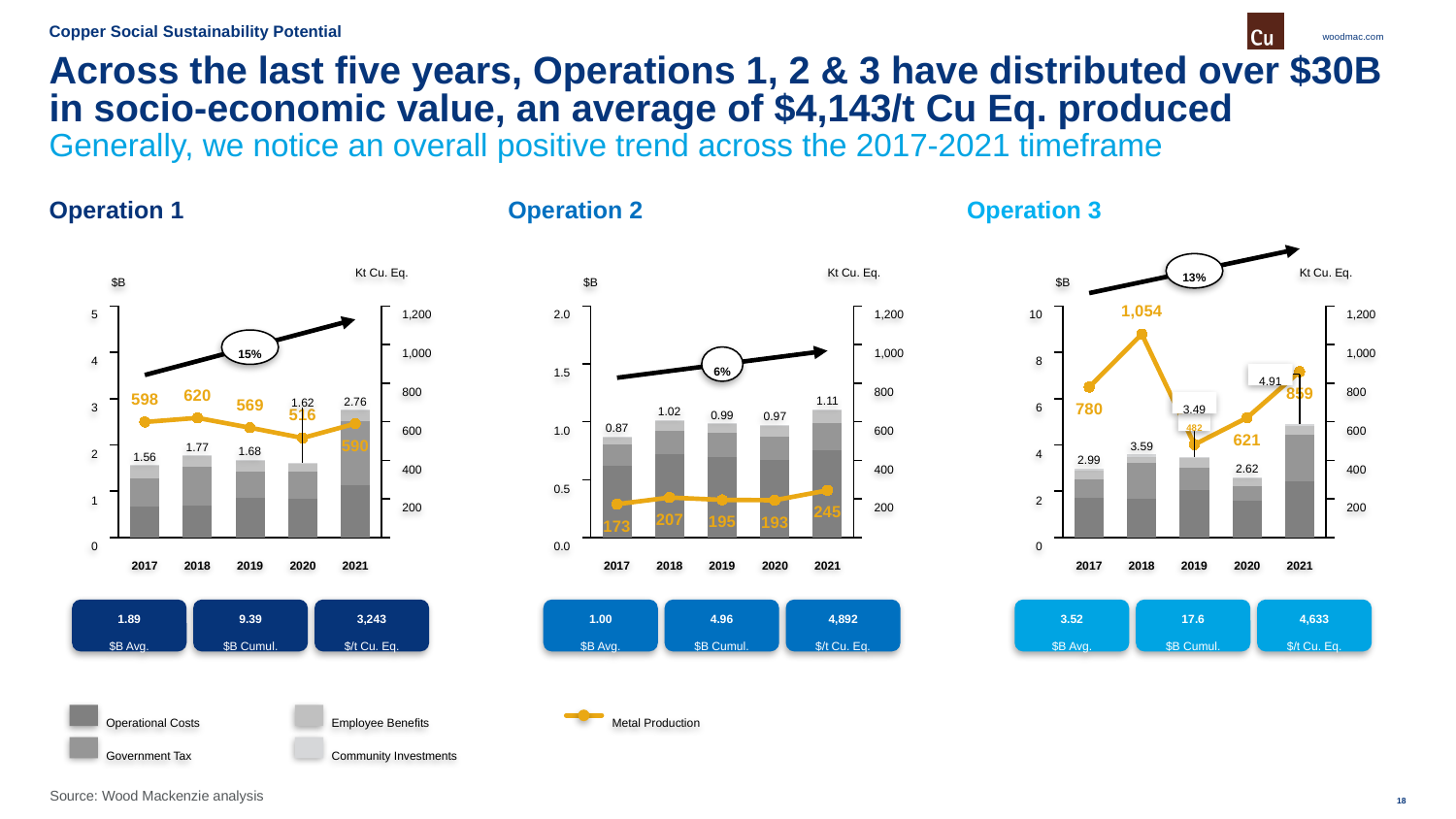
In the Operation 1 chart, what is the Metal Production value for 2020? 516 How many series does the legend at the bottom of the slide list? 5 In the Operation 3 chart, what is the difference between the Metal Production values for 2018 and 2017? 274 How many years are shown on the x axis of the Operation 1 chart? 5 In the Operation 2 chart, which year has the larger total bar value, 2018 or 2019? 2018 In the Operation 2 chart, is the Metal Production value for 2021 greater or less than 400? less In the Operation 3 chart, which year has the highest Metal Production? 2018 In the Operation 2 chart, what is the Metal Production value for 2021? 245 In the Operation 1 chart, what is the difference between the total bar values for 2021 and 2017? 1.20 In the Operation 3 chart, what is the Metal Production value for 2019? 482 In the Operation 3 chart, which year has the lowest total bar value? 2020 In the Operation 1 chart, what is the total value of the bar for 2021? 2.76